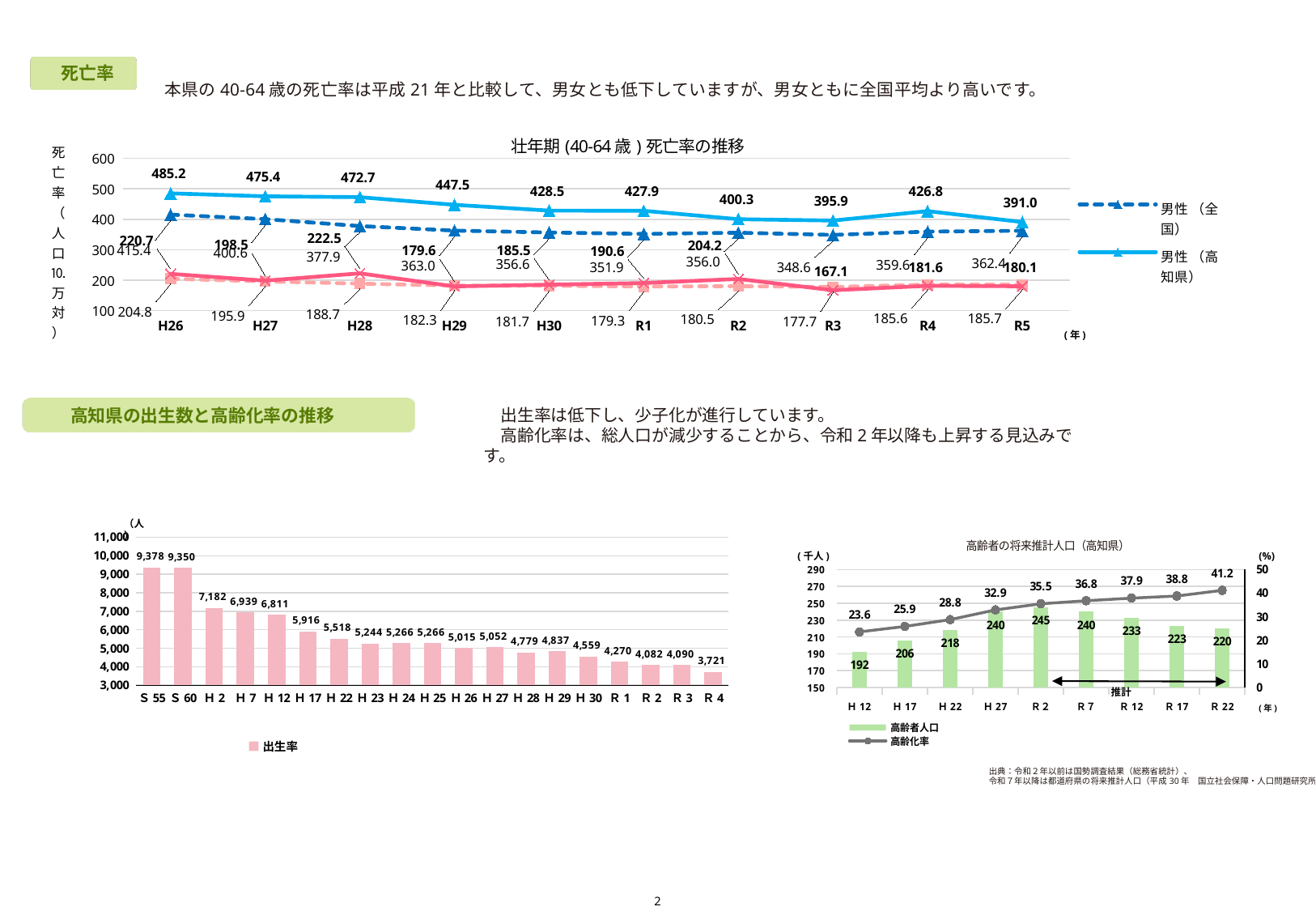
In the bottom-right chart 高齢者の将来推計人口（高知県）, in which year is 高齢者人口 highest? R 2 In the bottom-left bar chart of births, how many categories are shown on the x axis? 19 In the top chart 壮年期(40-64歳)死亡率の推移, in which year is 男性（高知県） lowest? R5 In the bottom-right chart 高齢者の将来推計人口（高知県）, what is the 高齢化率 value for R 22? 41.2 In the bottom-left bar chart of births, what is the difference between S 55 and R 4? 5,657 In the bottom-left bar chart of births, which category has the highest value? S 55 In the bottom-left bar chart of births, what is the value for H 22? 5,518 In the top chart 壮年期(40-64歳)死亡率の推移, what is the difference between 男性（高知県） and 男性（全国） in R2? 44.3 In the top chart 壮年期(40-64歳)死亡率の推移, what is the value for 男性（高知県） in H26? 485.2 In the top chart 壮年期(40-64歳)死亡率の推移, which is larger in H28: 男性（高知県） or 男性（全国）? 男性（高知県） In the top chart 壮年期(40-64歳)死亡率の推移, what is the value for 男性（全国） in R5? 362.4 In the bottom-right chart 高齢者の将来推計人口（高知県）, how many series does the legend list? 2